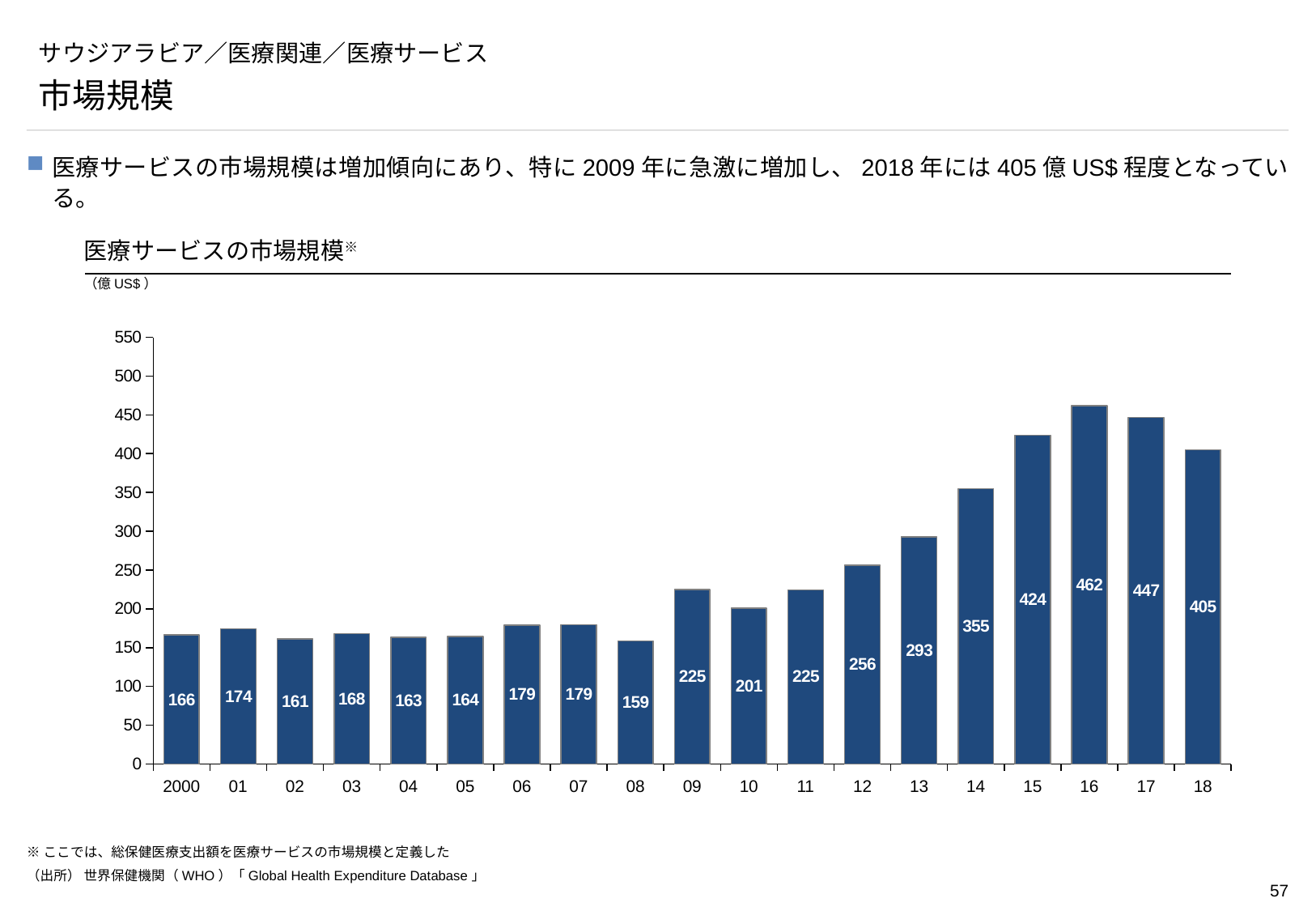
Which is larger, the value for 2014 or the value for 2013? 2014 What kind of chart is this? bar chart How many years are shown on the x axis? 19 What is the difference between the values for 2016 and 2018? 57 What is the difference between the values for 2009 and 2008? 66 What is the value for 2000? 166 Which year has the lowest value? 08 What is the value for 2018? 405 What is the value for 2009? 225 Which year has the highest value? 16 Is the value for 2015 greater or less than 400? greater What unit is shown for the values on the chart? 億US$